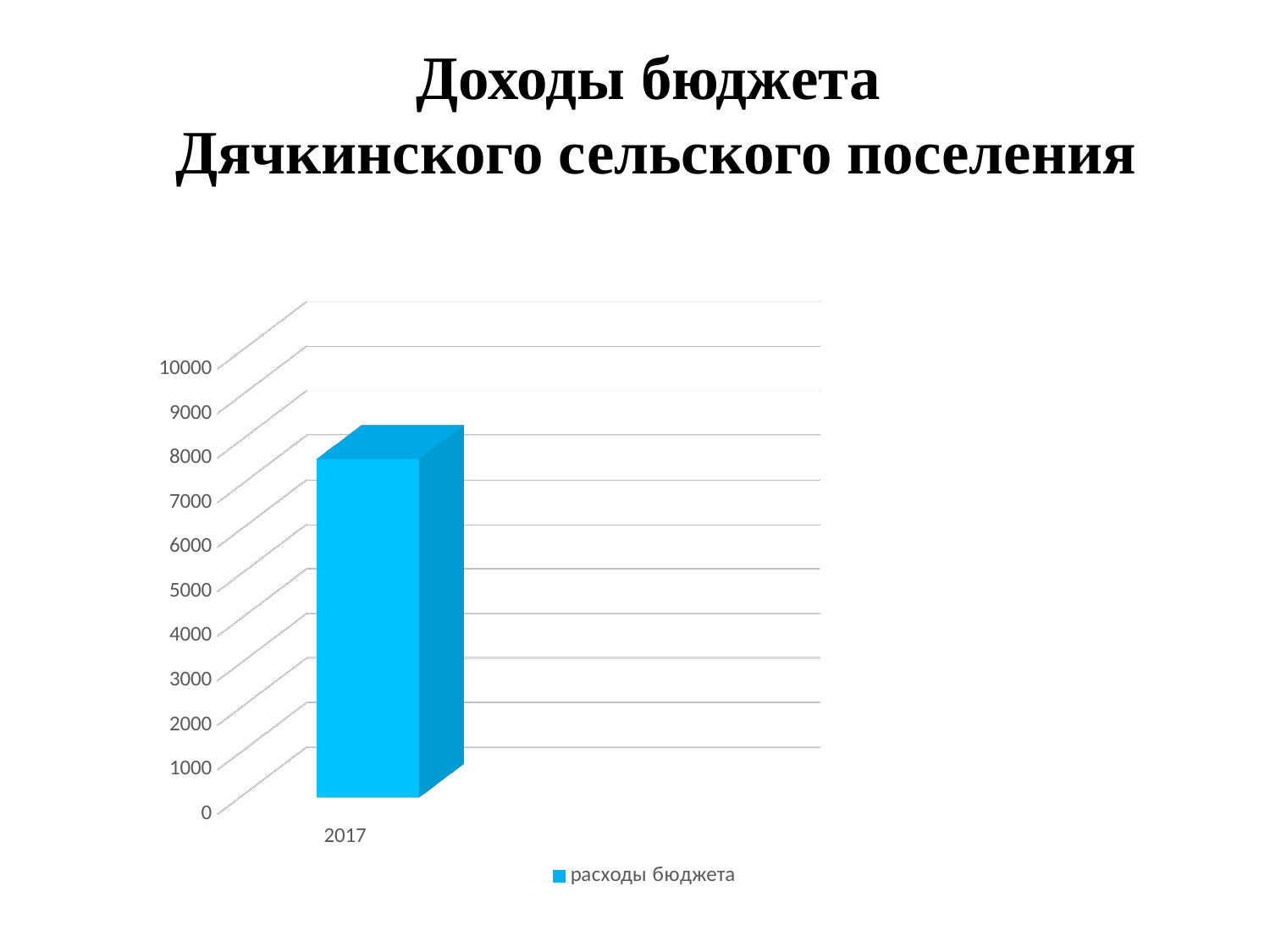
What kind of chart is shown on the slide? bar chart Which year is shown on the x axis of the chart? 2017 What series name is shown in the chart legend? расходы бюджета Is the value for 2017 greater or less than 9000? less Is the value for 2017 greater or less than 6000? greater How many series does the chart legend list? 1 Is the value for 2017 greater or less than 10000? less How many categories are plotted on the x axis of the chart? 1